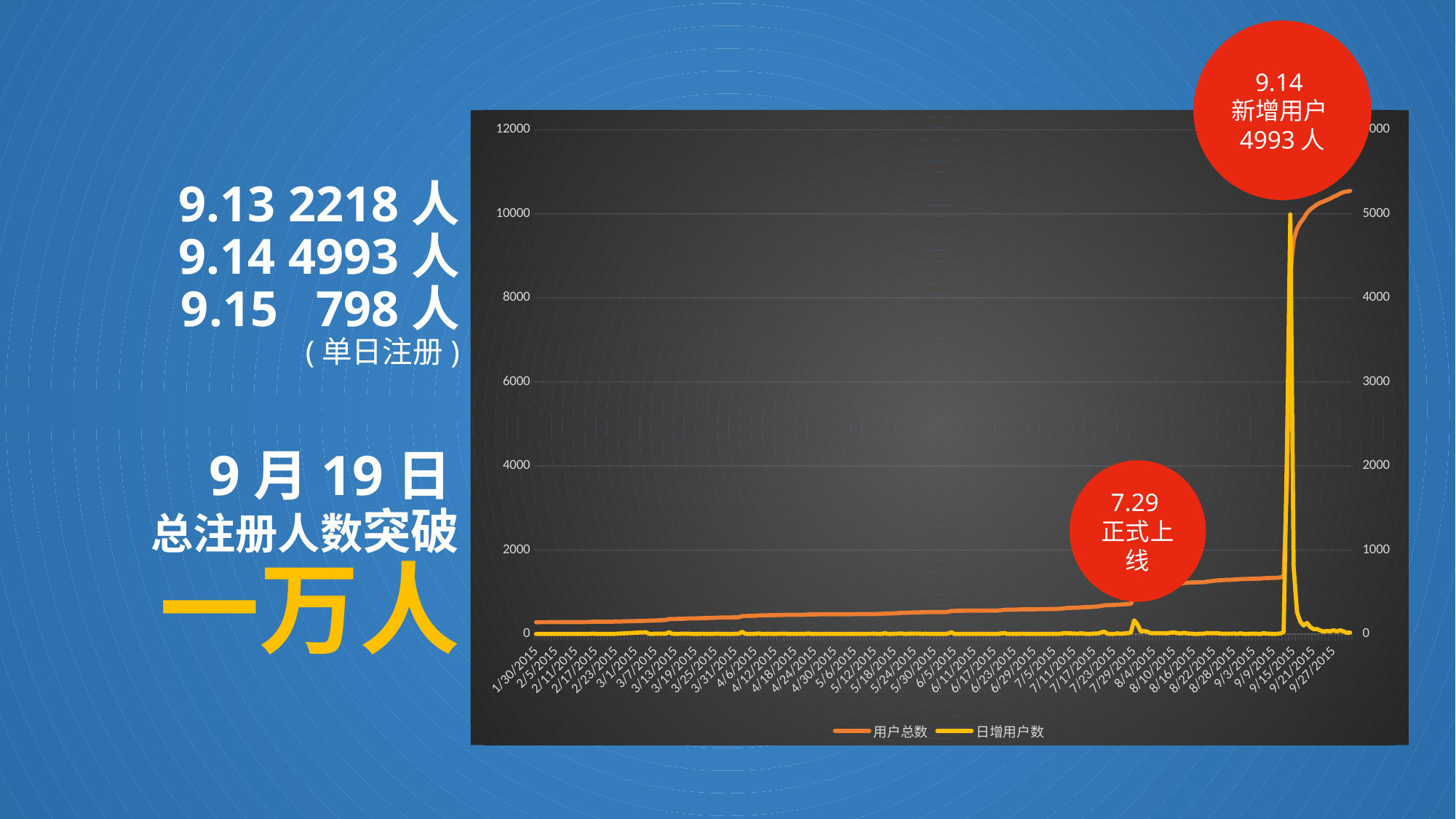
According to the annotation on the chart, how many new users (新增用户) were added on 9.14? 4993 人 On which date does the 日增用户数 series reach its highest peak? 9.14 Which day had more single-day registrations, 9.13 or 9.14? 9.14 What kind of chart is shown on the slide? line chart What are the two series named in the chart's legend? 用户总数 and 日增用户数 What event is annotated on the chart at 7.29? 正式上线 Is the final value of the 用户总数 series at the right end of the chart greater or less than 10000 on the left axis? greater How many series does the chart's legend list? 2 Does the 用户总数 series rise or fall along the x axis from 1/30/2015 to 9/27/2015? rise What is the difference between the single-day registrations on 9.14 (4993 人) and 9.13 (2218 人)? 2775 人 Is the peak value of the 日增用户数 series greater or less than 4000 on the right axis? greater What is the highest tick value shown on the left vertical axis of the chart? 12000